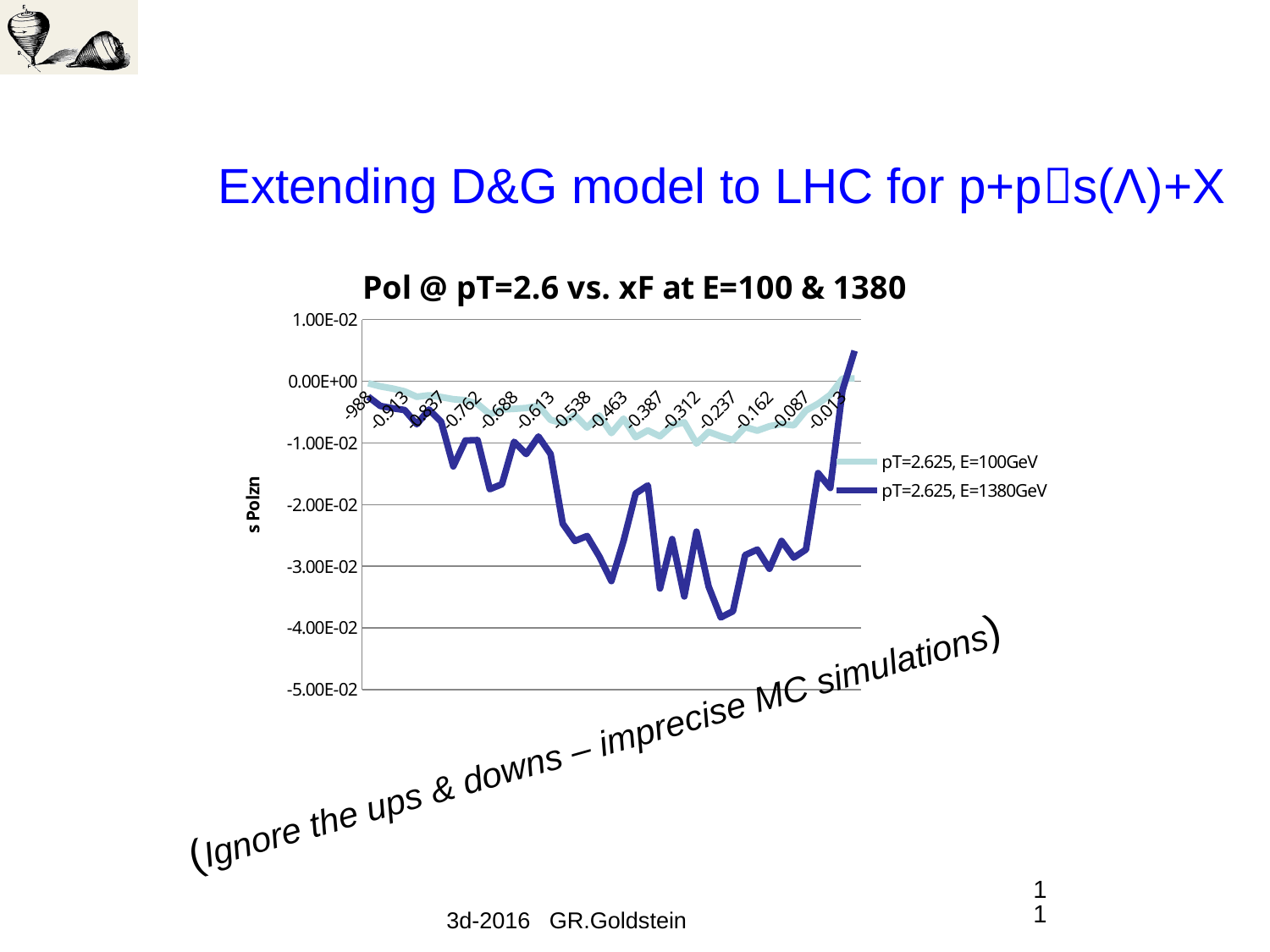
How many series does the legend list? 2 What is the lowest value shown on the y axis? -5.00E-02 Is the value of the pT=2.625, E=1380GeV series at xF=-0.762 greater or less than -2.00E-02? greater Is the value of the pT=2.625, E=100GeV series at xF=-0.988 greater or less than -1.00E-02? greater What is the title of the chart? Pol @ pT=2.6 vs. xF at E=100 & 1380 What are the two legend entries of the chart? pT=2.625, E=100GeV and pT=2.625, E=1380GeV Which series stays closer to 0.00E+00 across the x axis? pT=2.625, E=100GeV What kind of chart is shown on the slide? line chart How many x-axis category labels are shown on the chart? 14 Does the pT=2.625, E=1380GeV series generally rise or fall from xF=-0.988 to xF=-0.237? fall Which series reaches the lowest value on the chart? pT=2.625, E=1380GeV Is the value of the pT=2.625, E=1380GeV series at xF=-0.237 greater or less than -3.00E-02? less